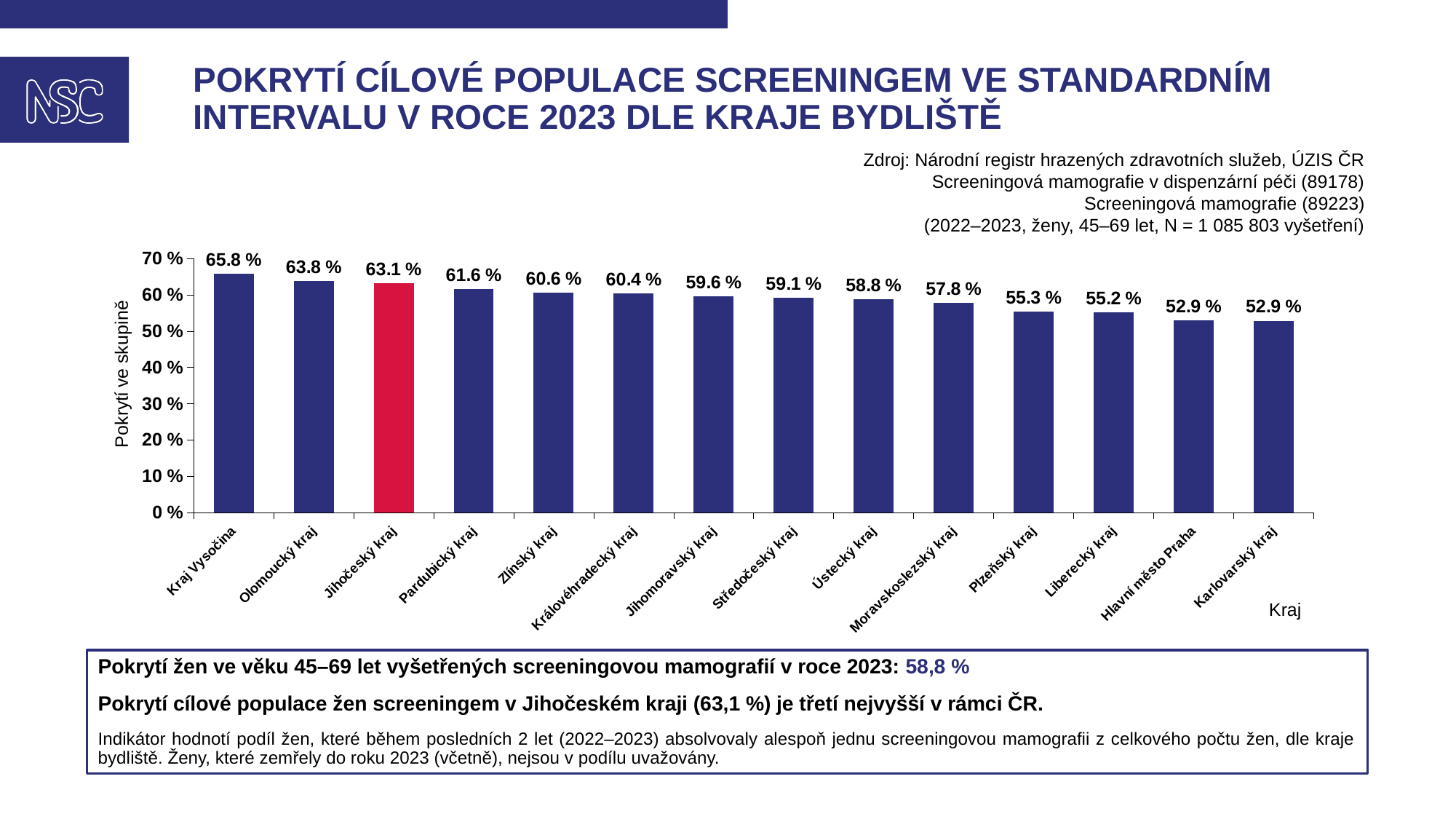
What is the value for Jihočeský kraj? 63.1 % Which is larger, the value for Zlínský kraj or the value for Plzeňský kraj? Zlínský kraj What is the value for Hlavní město Praha? 52.9 % What is the difference between the values for Kraj Vysočina and Olomoucký kraj? 2.0 % What is the value for Moravskoslezský kraj? 57.8 % What kind of chart is shown on the slide? bar chart How many regions are shown on the x axis? 14 Which region's bar is highlighted in red? Jihočeský kraj What is the difference between the values for Jihočeský kraj and Pardubický kraj? 1.5 % Is the value for Moravskoslezský kraj greater or less than 60 %? less What is the value for Kraj Vysočina? 65.8 % Which region has the highest value? Kraj Vysočina